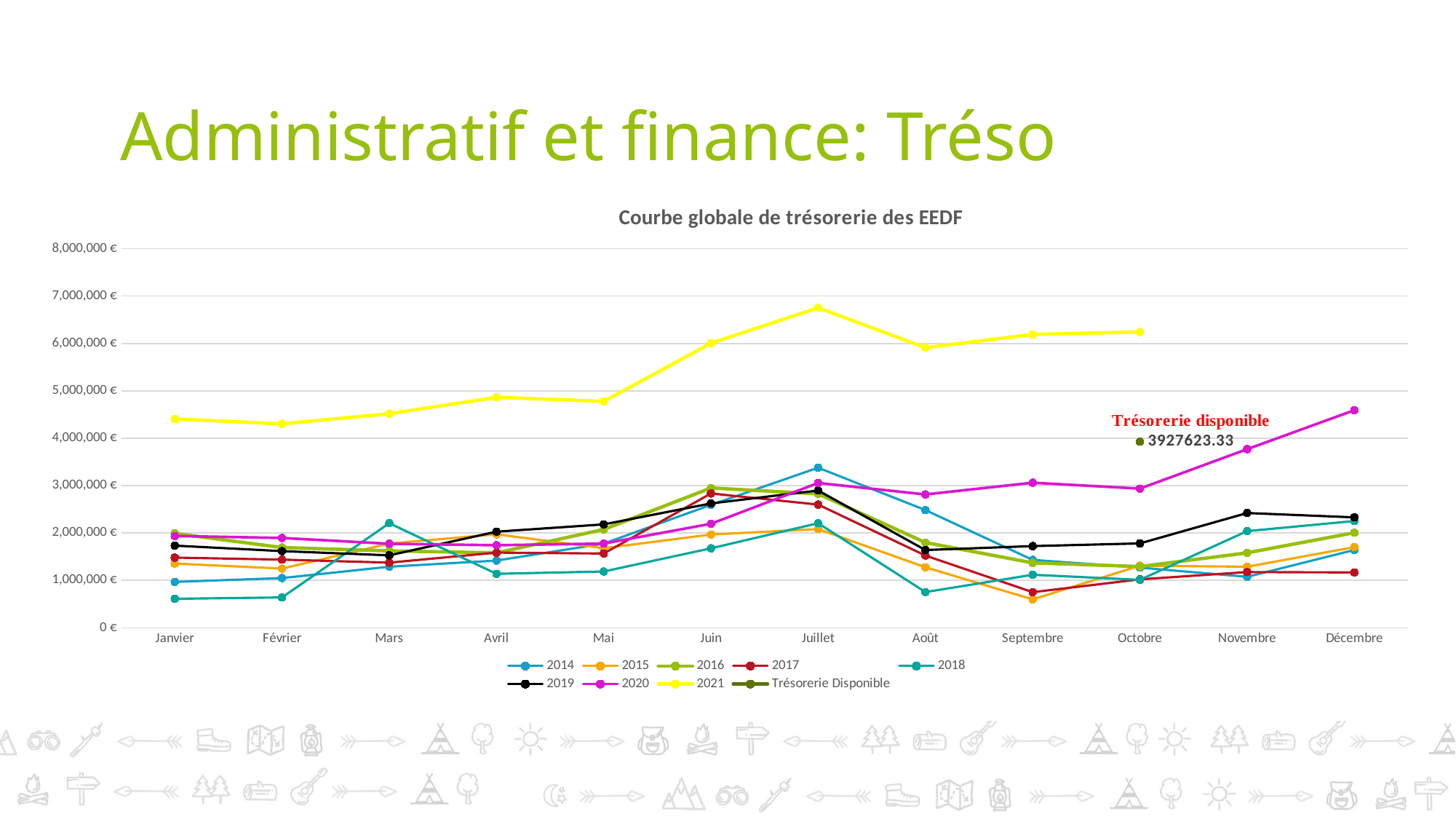
What kind of chart is shown on the slide? line chart Which series has the highest value in Juillet? 2021 Does the 2021 series rise or fall from Janvier to Juillet? rise Is the value for 2018 in Août greater or less than 1,000,000 €? less Is the value for 2021 in Juillet greater or less than 6,000,000 €? greater How many months are shown along the x axis? 12 How many series does the legend list? 9 In Octobre, which is larger: the value for 2021 or the value for 2020? 2021 What value is printed for the Trésorerie Disponible point? 3927623.33 What is the title of the chart? Courbe globale de trésorerie des EEDF Which series has the lowest value in Janvier? 2018 In which month does the 2021 series reach its highest value? Juillet